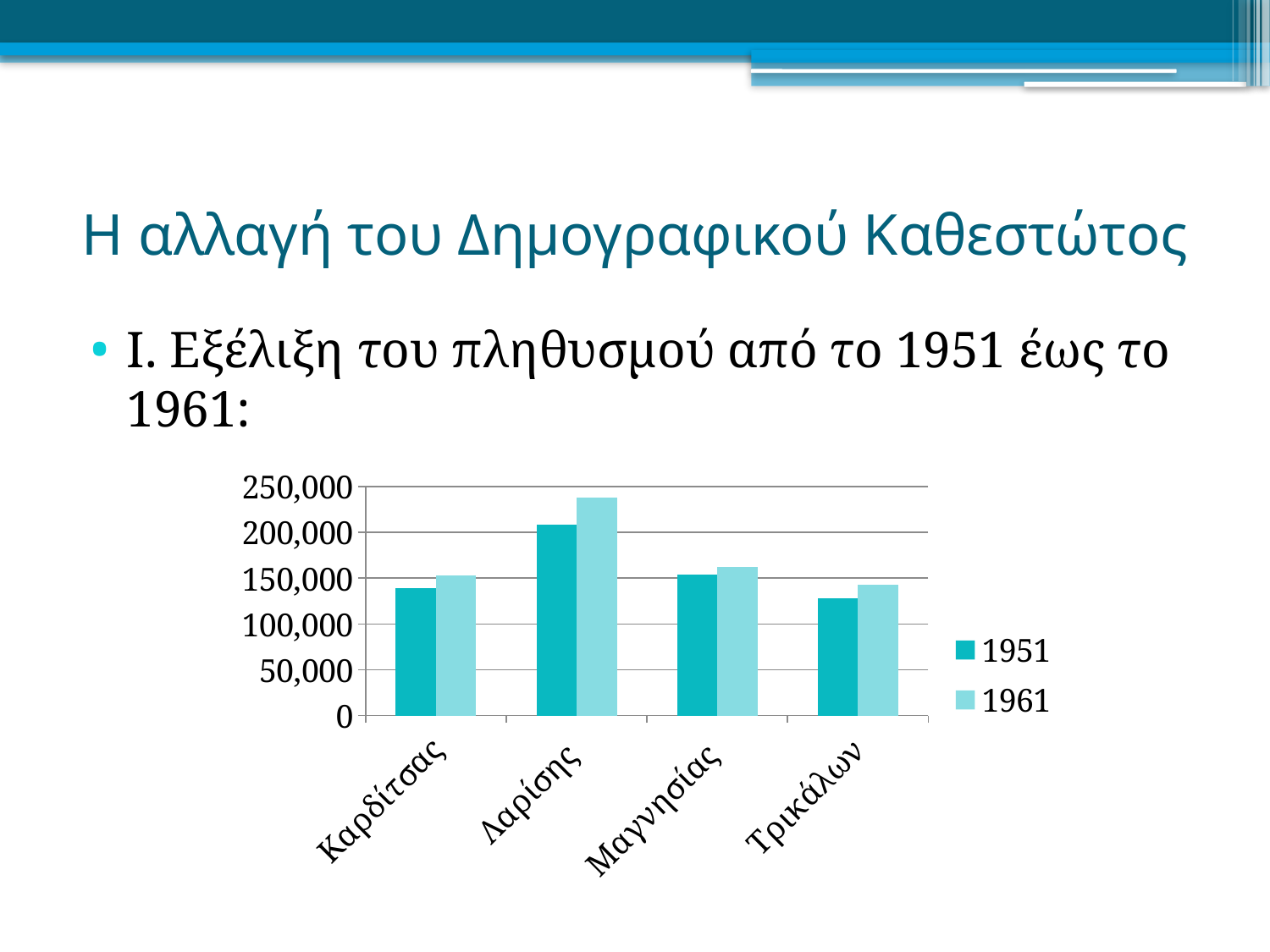
Which years are listed in the chart legend? 1951 and 1961 Is the 1951 value for Λαρίσης greater or less than 200,000? greater How many series does the chart legend list? 2 Which category has the lowest value for 1961? Τρικάλων How many categories (prefectures) are shown on the x axis of the chart? 4 Which category has the highest value for 1961? Λαρίσης Is the 1961 value for Μαγνησίας greater or less than 150,000? greater For Καρδίτσας, which is larger: the 1951 value or the 1961 value? 1961 Is the 1951 value for Τρικάλων greater or less than 150,000? less Which category has the highest value for 1951? Λαρίσης What kind of chart is shown on the slide? bar chart Which category has the lowest value for 1951? Τρικάλων